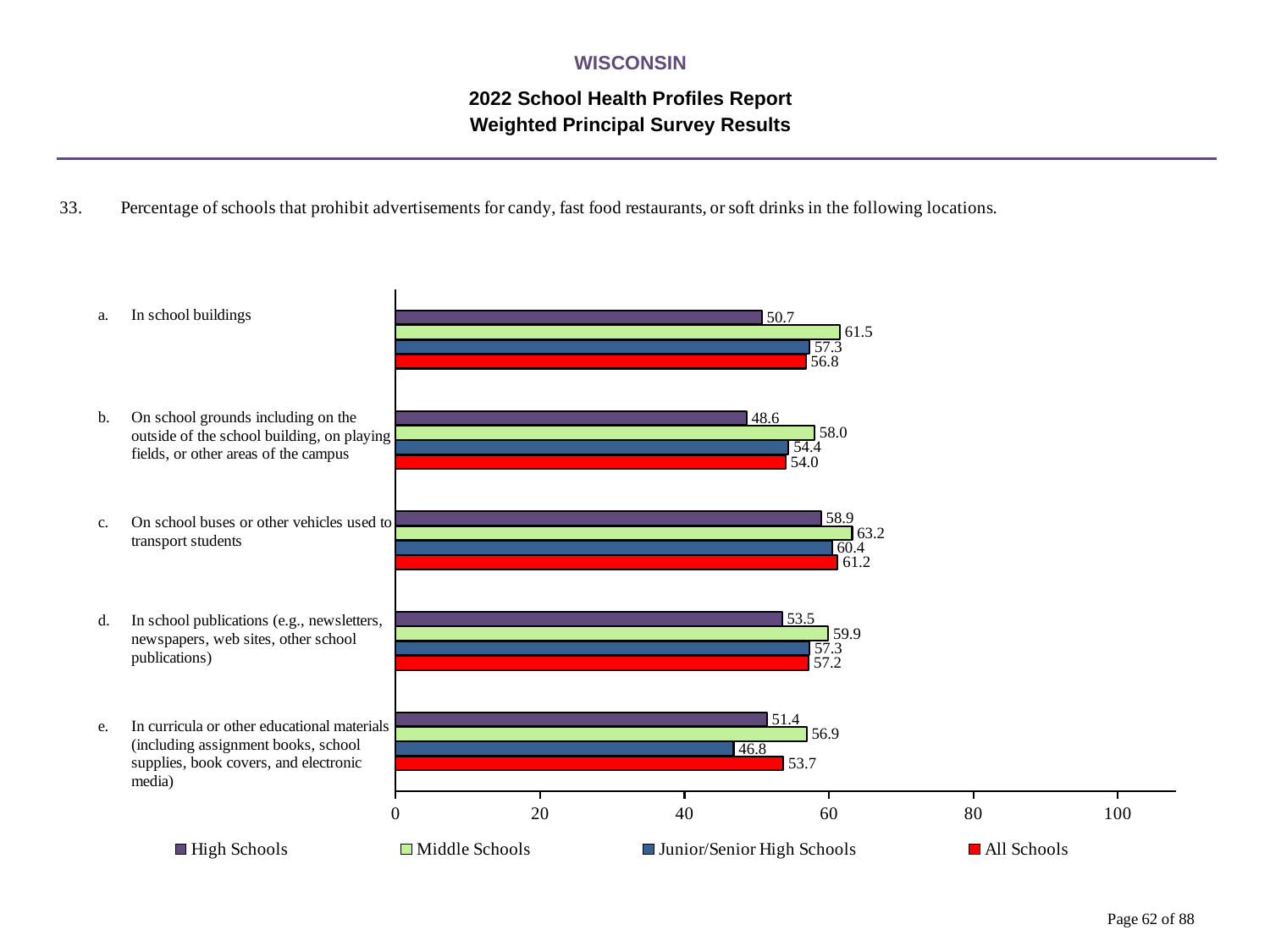
Which location has the highest value for All Schools? On school buses or other vehicles used to transport students What is the value for All Schools for 'On school grounds including on the outside of the school building, on playing fields, or other areas of the campus'? 54.0 Which location has the lowest value for High Schools? On school grounds including on the outside of the school building, on playing fields, or other areas of the campus Which series is shown in red in the legend? All Schools What is the value for Middle Schools for 'On school buses or other vehicles used to transport students'? 63.2 What is the value for Junior/Senior High Schools for 'In curricula or other educational materials'? 46.8 For 'In school publications', which is larger: the Middle Schools value or the All Schools value? Middle Schools What is the value for High Schools for 'In school buildings'? 50.7 What is the difference between the Middle Schools and High Schools values for 'In school buildings'? 10.8 How many locations (categories) are shown in the chart? 5 How many series does the legend list? 4 What kind of chart is shown on the slide? Bar chart